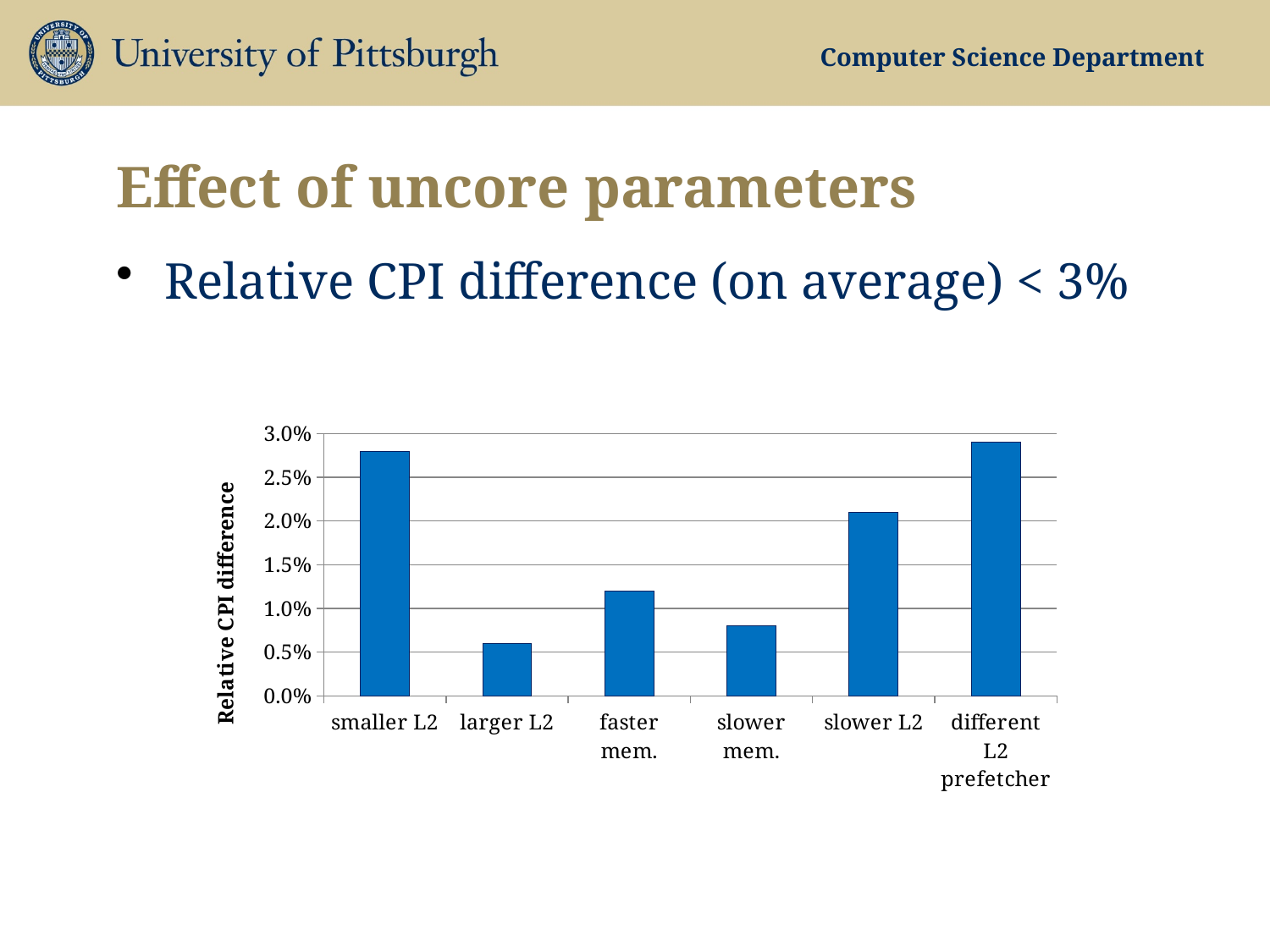
Is the value for larger L2 greater or less than 1.0%? less Is the value for slower mem. greater or less than 1.0%? less Is the value for faster mem. greater or less than 1.0%? greater Which has a larger relative CPI difference, faster mem. or slower mem.? faster mem. Which has a larger relative CPI difference, smaller L2 or larger L2? smaller L2 How many categories are plotted on the x axis of the chart? 6 What kind of chart is shown on the slide? bar chart What is the label of the y axis of the chart? Relative CPI difference Which category has the lowest relative CPI difference? larger L2